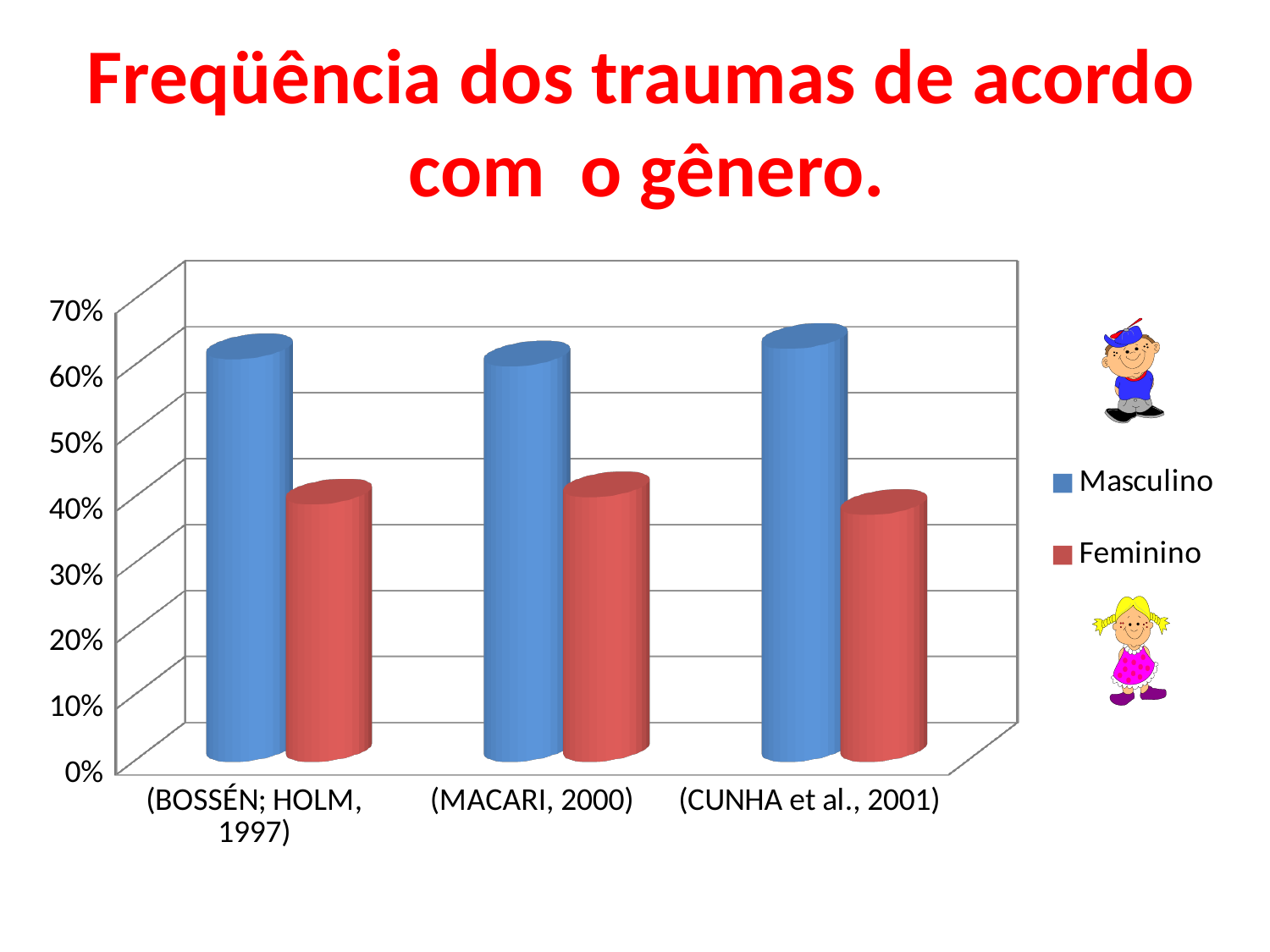
How many series does the legend list? 2 Which series is larger for (CUNHA et al., 2001), Masculino or Feminino? Masculino Is the Feminino value for (MACARI, 2000) greater or less than 30%? greater Is the Masculino value for (CUNHA et al., 2001) greater or less than 50%? greater Is the Feminino value for (CUNHA et al., 2001) greater or less than 50%? less What is the title of the slide? Freqüência dos traumas de acordo com o gênero. Which series is larger for (BOSSÉN; HOLM, 1997), Masculino or Feminino? Masculino Which colour represents the Feminino series in the legend? red What kind of chart is shown on the slide? bar chart How many study categories are shown on the x axis? 3 Which series is larger for (MACARI, 2000), Masculino or Feminino? Masculino